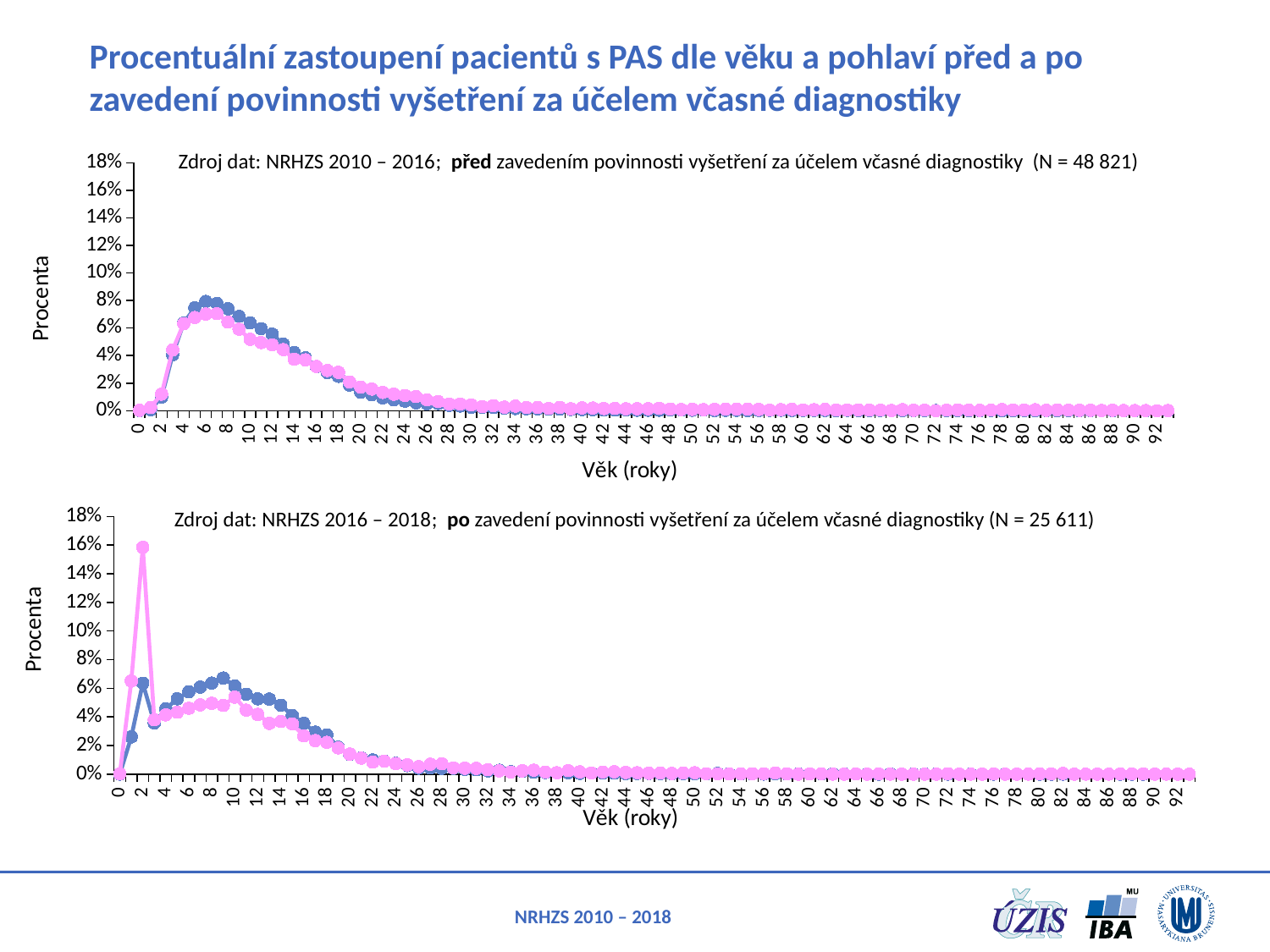
In the bottom chart (po zavedení), which series has the larger value at age 2, the blue or the pink one? pink In the top chart (před zavedením), is the blue series value at age 6 greater or less than 6%? greater In the bottom chart (po zavedení), is the blue series value at age 2 greater or less than 8%? less What is the N value stated in the title of the bottom chart (po zavedení)? N = 25 611 In the bottom chart (po zavedení), which series has the larger value at age 9, the blue or the pink one? blue In the bottom chart (po zavedení), is the pink series value at age 2 greater or less than 14%? greater What kind of chart is the top chart (před zavedením povinnosti vyšetření)? line chart In the bottom chart (po zavedení), at which age does the pink series reach its highest value? 2 What is the label of the x axis on both charts? Věk (roky) In the top chart (před zavedením), do the values rise or fall as age increases from 10 to 30? fall What kind of chart is the bottom chart (po zavedení povinnosti vyšetření)? line chart